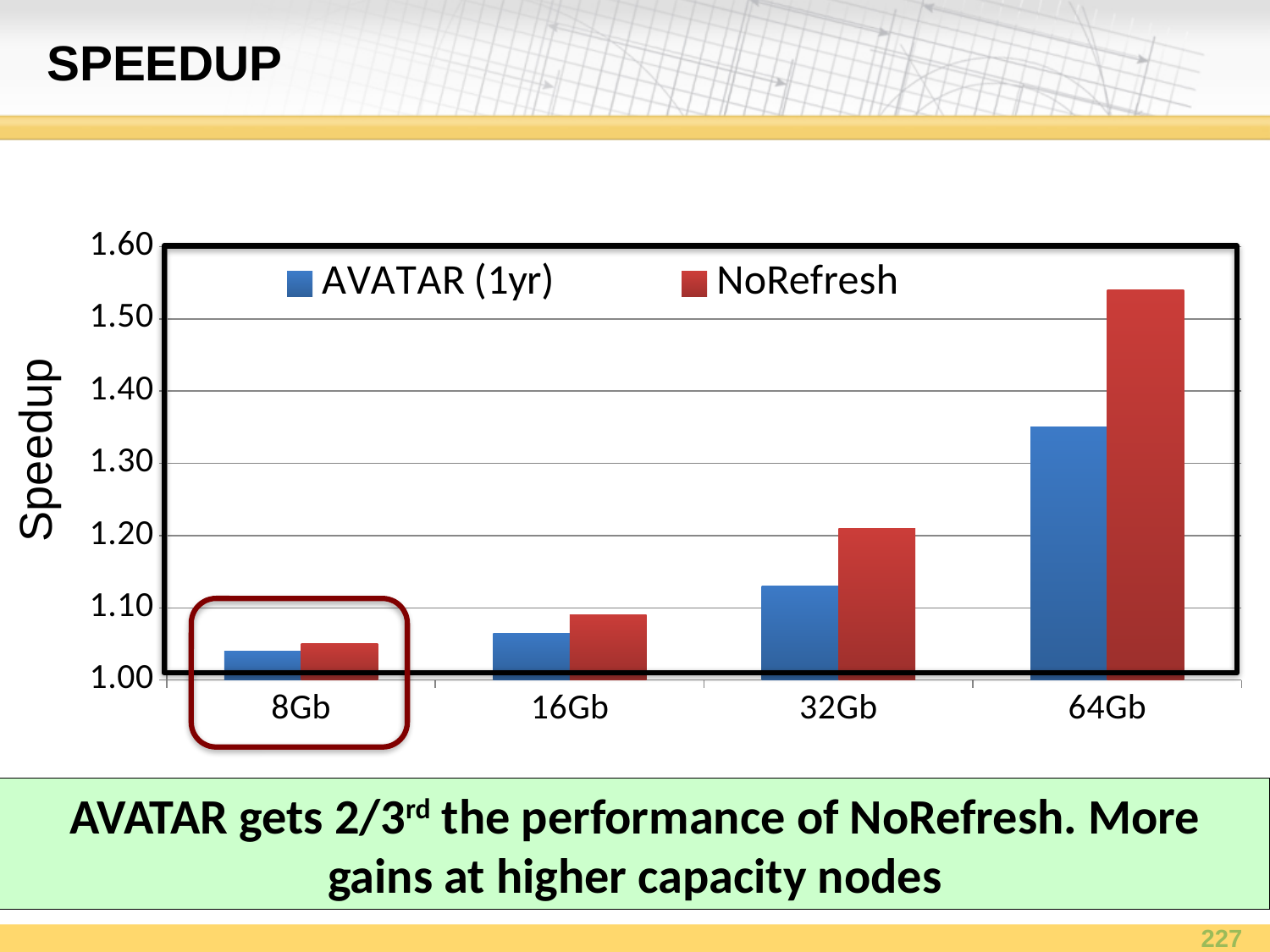
Is the NoRefresh speedup at 32Gb greater or less than 1.30? less How many series does the legend list? 2 At 64Gb, which series has the larger speedup, AVATAR (1yr) or NoRefresh? NoRefresh Is the NoRefresh speedup at 64Gb greater or less than 1.50? greater What kind of chart is shown on the slide? bar chart What is the label of the y axis? Speedup Is the NoRefresh speedup at 16Gb greater or less than 1.10? less Which capacity has the highest NoRefresh speedup? 64Gb Which capacity has the lowest AVATAR (1yr) speedup? 8Gb Do the NoRefresh speedup values rise or fall as capacity increases from 8Gb to 64Gb? rise How many capacity categories are shown on the x axis? 4